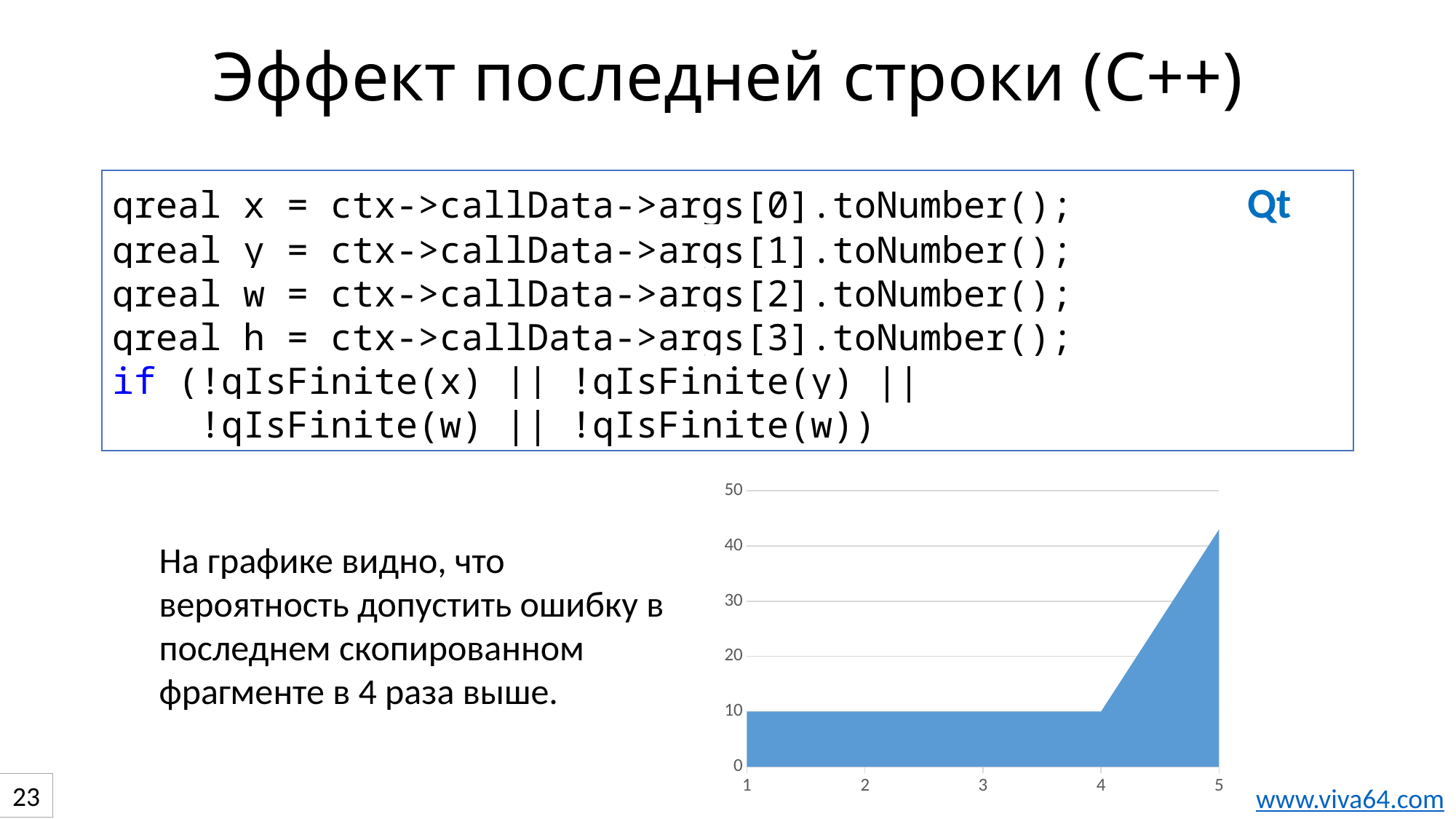
What colour is the filled area in the chart? blue What kind of chart is shown on the slide? area chart Do the values rise or fall between x = 4 and x = 5? rise What is the highest tick value shown on the y axis of the chart? 50 What is the value at x = 4 in the chart? 10 Is the value at x = 5 greater or less than 30? greater What is the value at x = 1 in the chart? 10 Which is larger, the value at x = 4 or the value at x = 5? 5 How many points are plotted along the x axis of the chart? 5 Which x-axis category has the highest value in the chart? 5 Is the value at x = 2 greater or less than 20? less